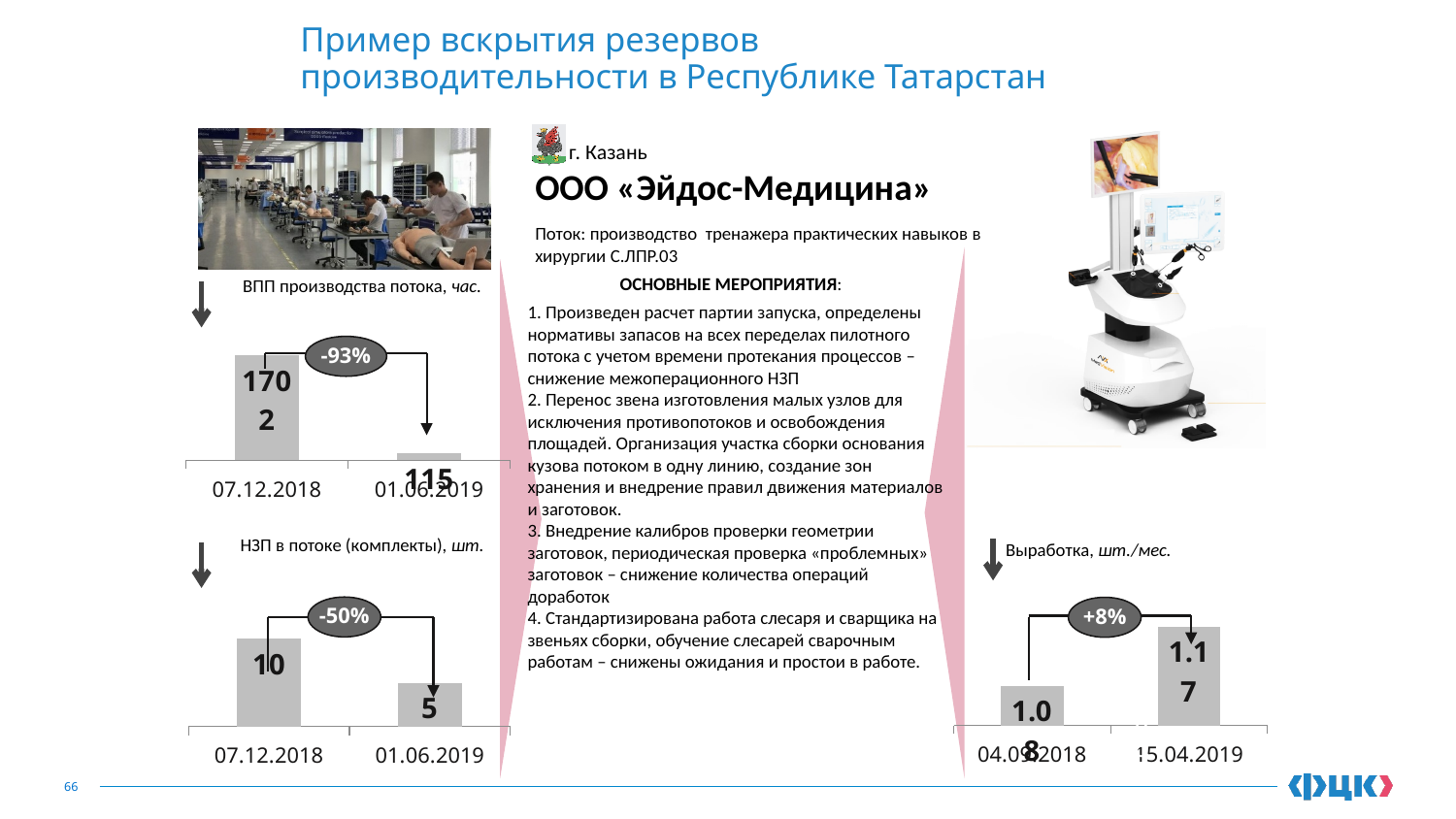
On the chart titled "ВПП производства потока, час.", what percentage change is shown between the two bars? -93% On the chart titled "НЗП в потоке (комплекты), шт.", what is the value for 07.12.2018? 10 On the chart titled "ВПП производства потока, час.", which date has the lower value? 01.06.2019 On the chart titled "НЗП в потоке (комплекты), шт.", what is the value for 01.06.2019? 5 On the chart titled "Выработка, шт./мес.", which date has the higher value, 04.09.2018 or 15.04.2019? 15.04.2019 On the chart titled "НЗП в потоке (комплекты), шт.", do the values rise or fall from 07.12.2018 to 01.06.2019? fall On the chart titled "Выработка, шт./мес.", do the values rise or fall from the first date to the second? rise On the chart titled "НЗП в потоке (комплекты), шт.", what is the difference between the 07.12.2018 and 01.06.2019 values? 5 How many bars are on the chart titled "ВПП производства потока, час."? 2 On the chart titled "ВПП производства потока, час.", what is the value for 01.06.2019? 115 What kind of chart is the one titled "Выработка, шт./мес."? bar chart On the chart titled "НЗП в потоке (комплекты), шт.", what percentage change is shown between the two bars? -50%